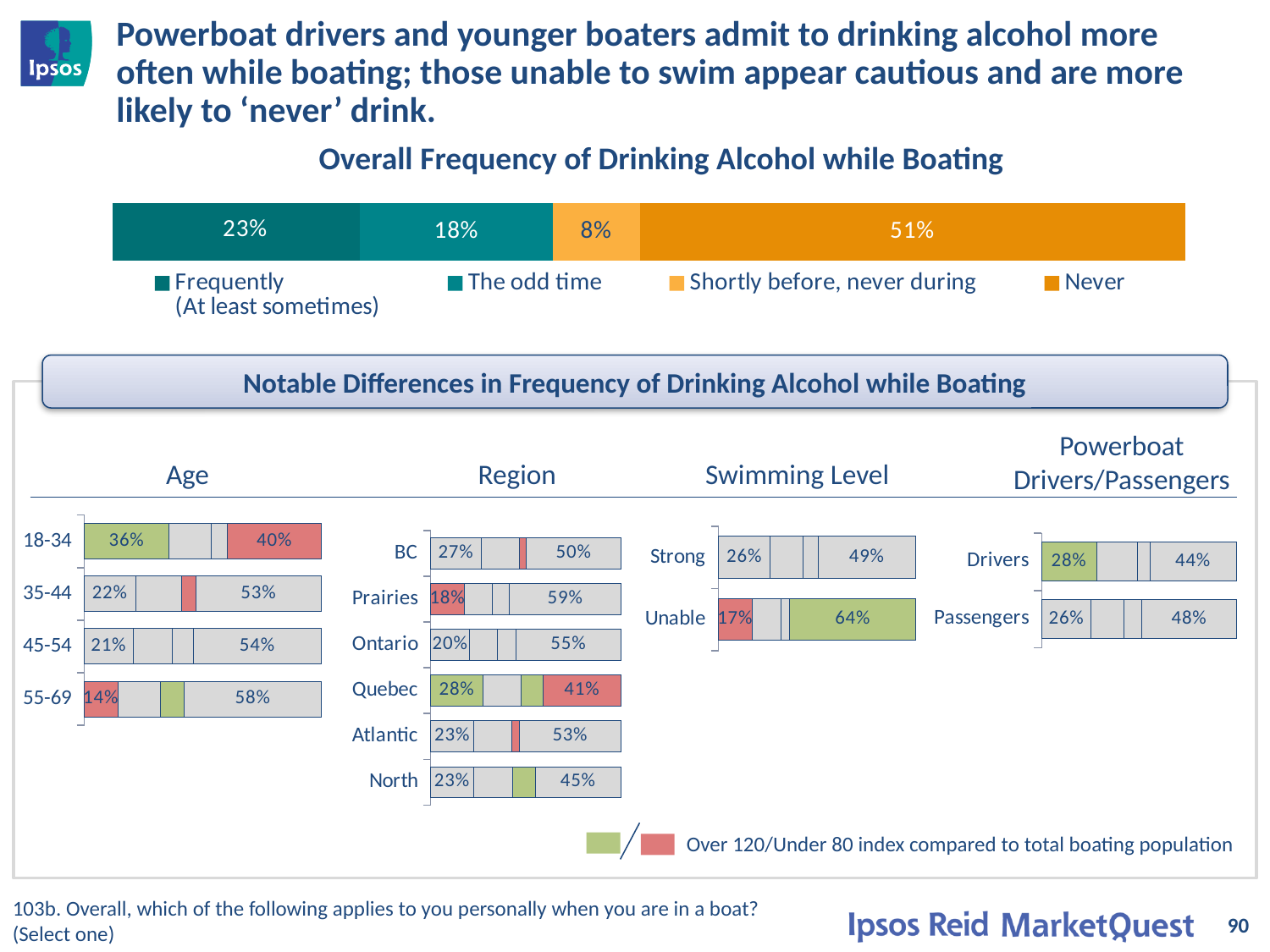
In the Swimming Level chart, what percentage of boaters unable to swim say they never drink while boating? 64% How many regions are shown in the Region chart? 6 In the Age chart, which age group has the highest 'Never' percentage? 55-69 In the 'Overall Frequency of Drinking Alcohol while Boating' chart, which category has the smallest share? Shortly before, never during In the 'Overall Frequency of Drinking Alcohol while Boating' chart, what percentage drink 'Frequently (At least sometimes)'? 23% In the Age chart, what percentage of 18-34 year olds drink frequently while boating? 36% In the Powerboat Drivers/Passengers chart, which group has the higher 'Frequently' percentage, Drivers or Passengers? Drivers In the 'Overall Frequency of Drinking Alcohol while Boating' chart, what is the difference between the 'Never' share and the 'Frequently' share? 28 percentage points In the Region chart, which region has the lowest 'Never' percentage? Quebec What kind of chart is the 'Overall Frequency of Drinking Alcohol while Boating' chart? Stacked bar chart In the 'Overall Frequency of Drinking Alcohol while Boating' chart, what percentage of boaters say they 'Never' drink alcohol while boating? 51% How many series does the legend of the 'Overall Frequency of Drinking Alcohol while Boating' chart list? 4